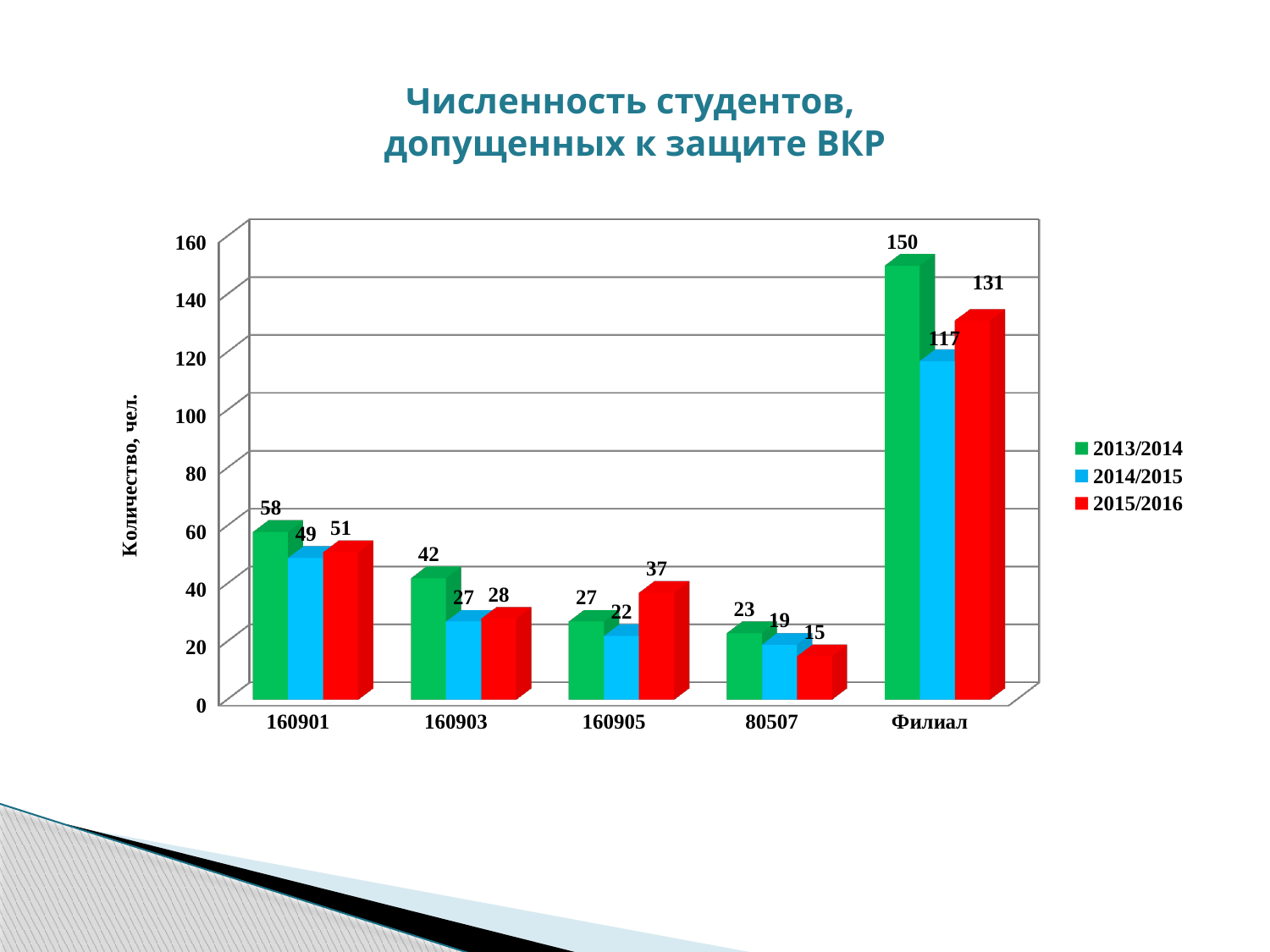
What is the value for 160901 in the 2013/2014 series? 58 What is the difference between the 2013/2014 and 2015/2016 values for Филиал? 19 What kind of chart is shown on the slide? Bar chart How many series does the legend list? 3 What is the value for Филиал in the 2014/2015 series? 117 Which is larger for 160903: the 2014/2015 value or the 2015/2016 value? 2015/2016 What is the label of the vertical axis? Количество, чел. What is the value for 160905 in the 2015/2016 series? 37 Which category has the highest value in the 2013/2014 series? Филиал Do the values for 80507 rise or fall from 2013/2014 to 2015/2016? Fall How many categories are shown on the x axis? 5 Which category has the lowest value in the 2015/2016 series? 80507